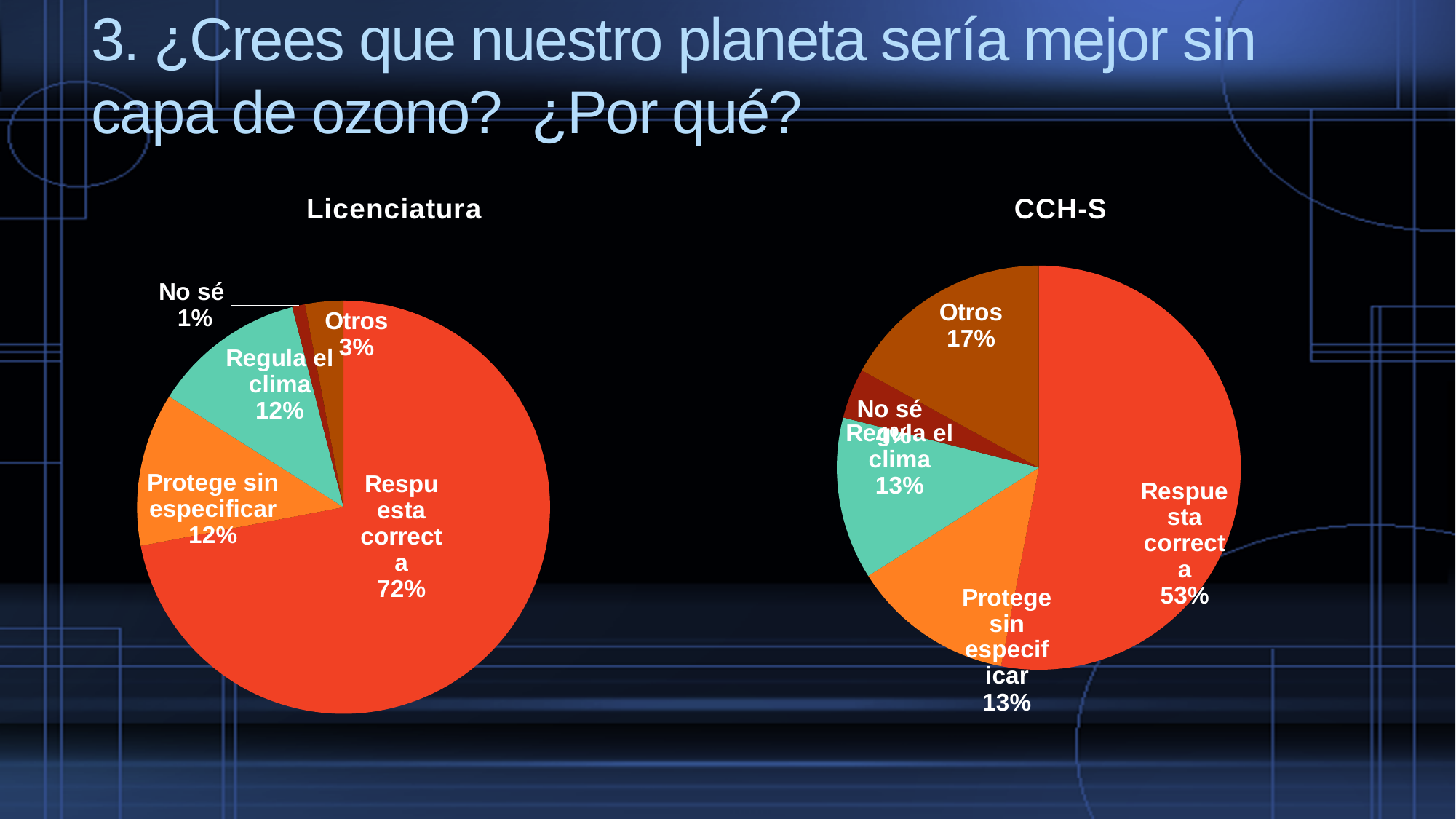
In the Licenciatura pie chart, what share is labelled for Respuesta correcta? 72% In the CCH-S pie chart, what share is labelled for Respuesta correcta? 53% In the Licenciatura pie chart, which category has the smallest slice? No sé What is the difference between the Respuesta correcta share in the Licenciatura chart and in the CCH-S chart? 19 percentage points In the Licenciatura pie chart, which category has the largest slice? Respuesta correcta In the CCH-S pie chart, what share is labelled for Otros? 17% In the CCH-S pie chart, which category has the largest slice? Respuesta correcta Which chart has the larger Otros share, Licenciatura or CCH-S? CCH-S What type of chart is used for the Licenciatura data? Pie chart